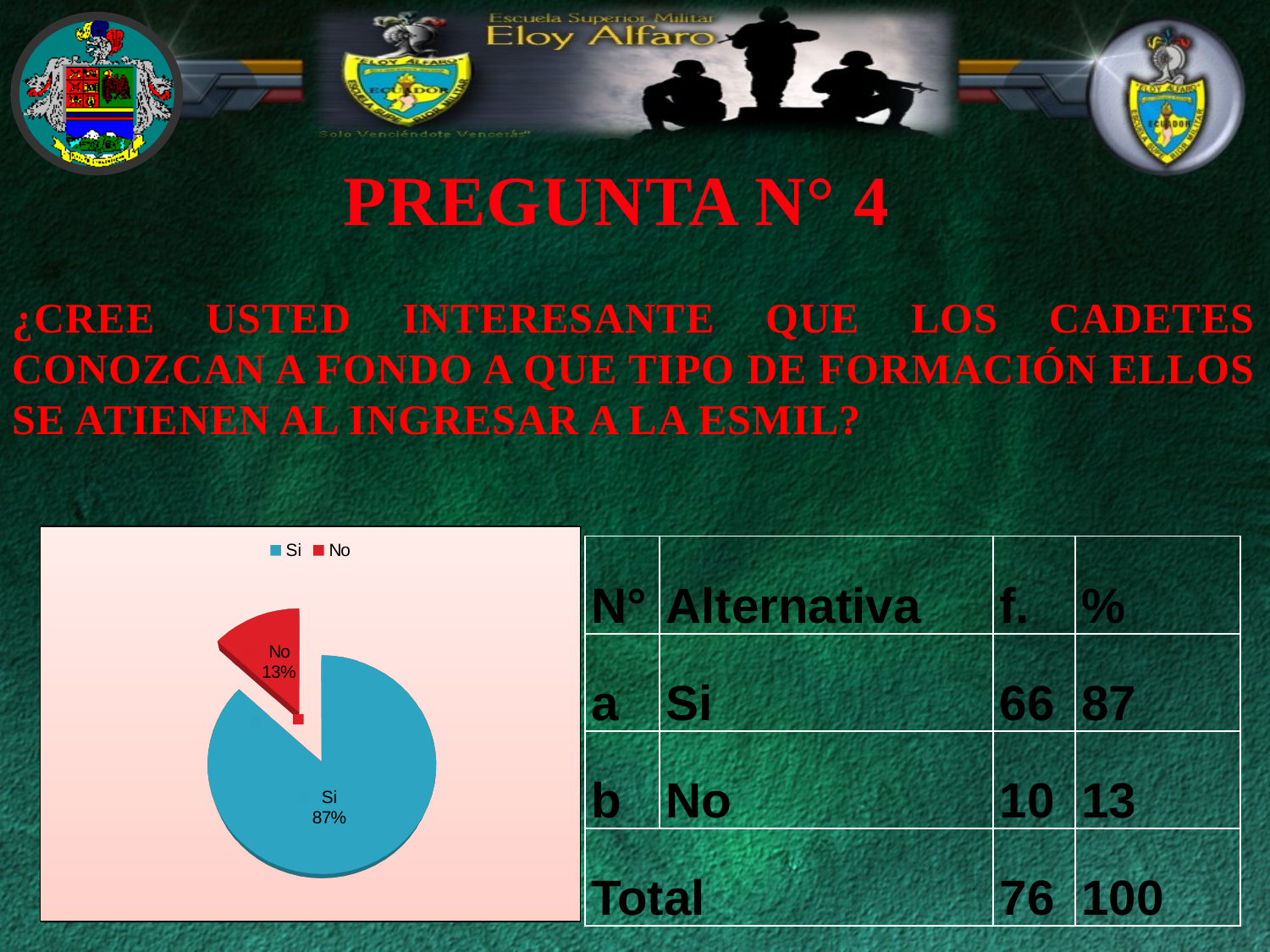
Which is larger in the pie chart, Si or No? Si What is the difference in percentage points between the Si and No slices? 74 What type of chart is shown on the slide? pie chart What colour is the No slice in the pie chart? red What percentage does the No slice show in the pie chart? 13% Which slice of the pie chart is the largest? Si Which slice of the pie chart is the smallest? No How many entries does the legend of the pie chart list? 2 How many slices does the pie chart have? 2 What percentage does the Si slice show in the pie chart? 87% What colour is the Si slice in the pie chart? blue Is the share of the Si slice greater or less than 50%? greater